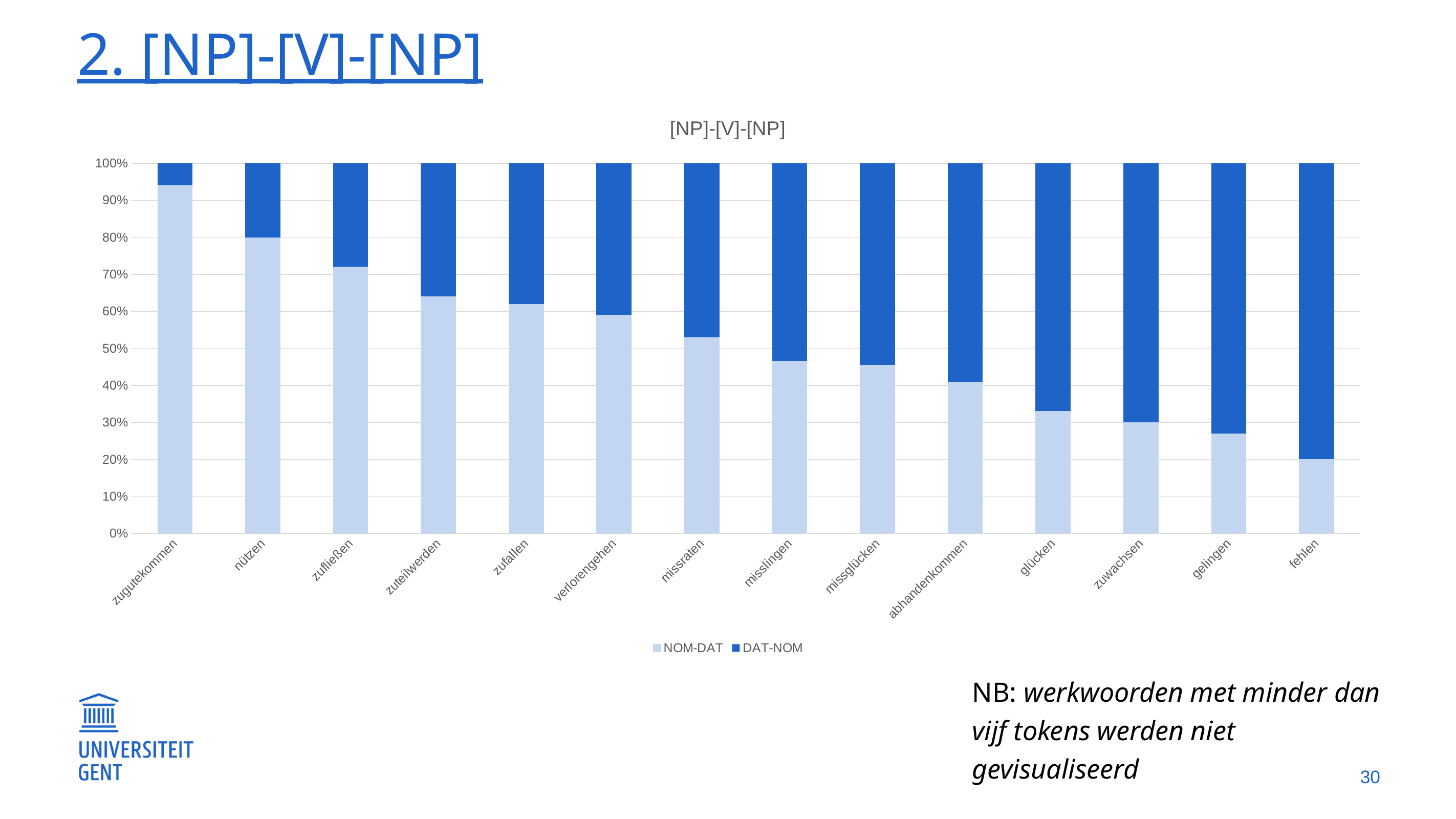
What kind of chart is shown on the slide? stacked bar chart What is the NOM-DAT share for nützen? 80% How many verbs (categories) are shown on the x axis of the chart? 14 Is the NOM-DAT share for zugutekommen greater or less than 90%? greater How many series does the legend of the chart list? 2 What is the NOM-DAT share for fehlen? 20% Is the NOM-DAT share for abhandenkommen greater or less than 50%? less Which verb has the lowest NOM-DAT share in the chart? fehlen Does the NOM-DAT share rise or fall from left to right along the x axis? fall What is the title of the chart? [NP]-[V]-[NP] Which verb has the largest DAT-NOM share in the chart? fehlen Which verb has the highest NOM-DAT share in the chart? zugutekommen